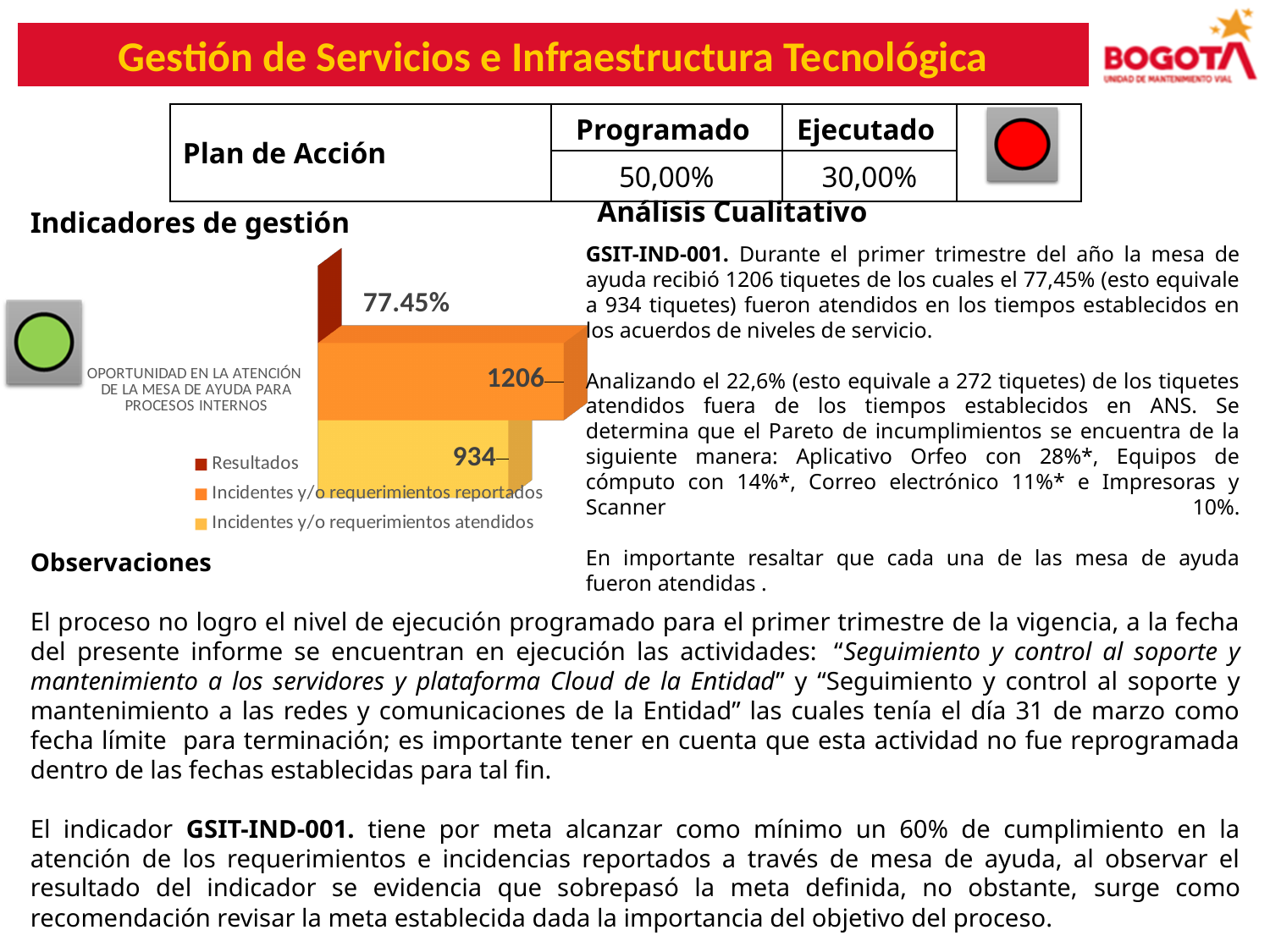
What is the name of the category shown on the chart's axis? OPORTUNIDAD EN LA ATENCIÓN DE LA MESA DE AYUDA PARA PROCESOS INTERNOS What kind of chart is shown under "Indicadores de gestión"? Bar chart Which legend entry in the chart is shown in dark red? Resultados What is the difference between the reported incidents (1206) and the attended incidents (934) in the chart? 272 How many categories are plotted on the chart's category axis? 1 What value is shown for the series "Incidentes y/o requerimientos atendidos" in the chart? 934 What value is shown for the series "Resultados" in the chart? 77.45% How many series does the chart legend list? 3 Which is larger in the chart: "Incidentes y/o requerimientos reportados" or "Incidentes y/o requerimientos atendidos"? Incidentes y/o requerimientos reportados What value is shown for the series "Incidentes y/o requerimientos reportados" in the chart? 1206 Which series has the largest bar in the chart? Incidentes y/o requerimientos reportados